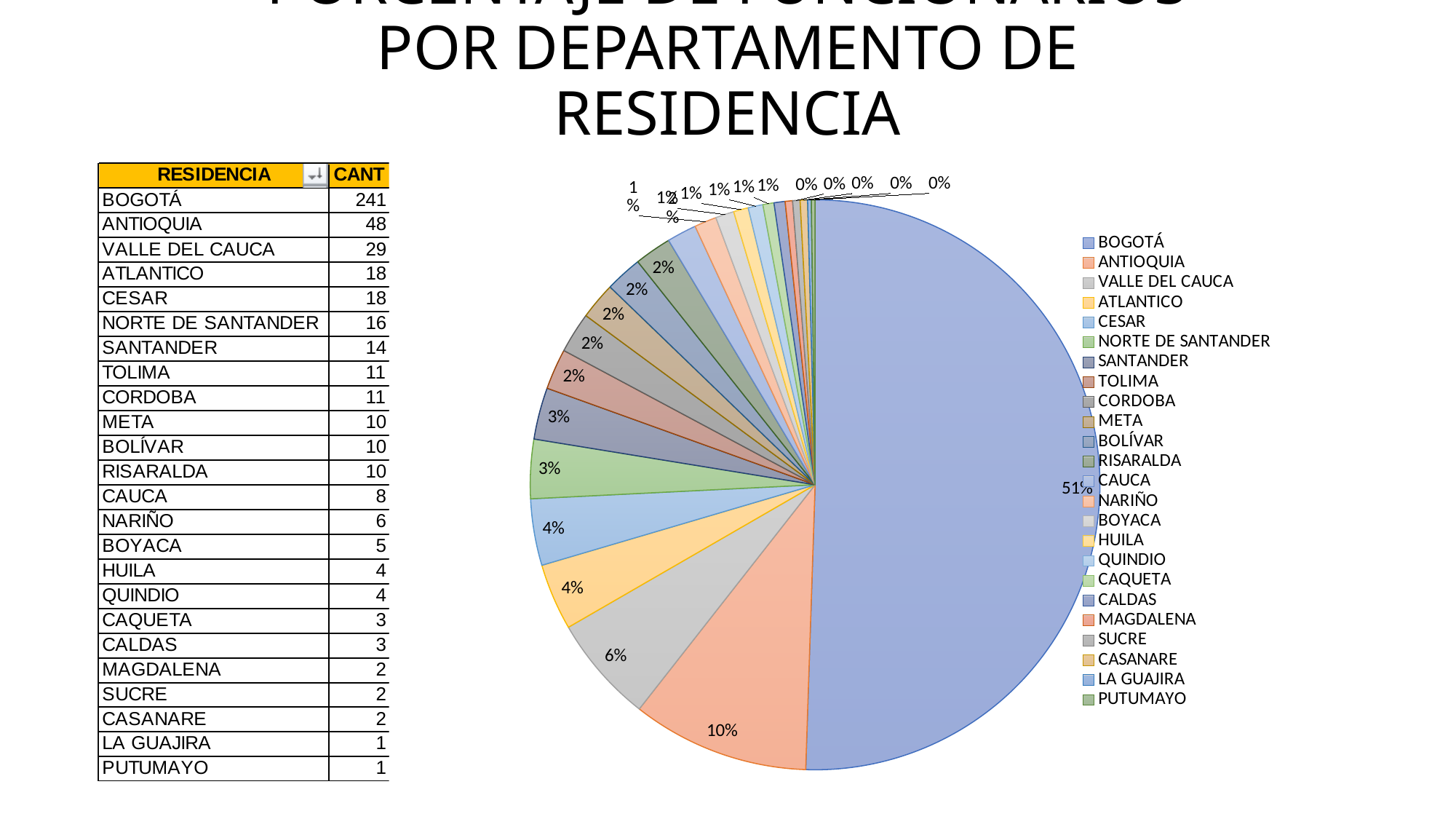
What is the difference in percentage points between the ANTIOQUIA slice and the VALLE DEL CAUCA slice? 4 What kind of chart is shown on the slide? pie chart Which department is listed first in the legend of the pie chart? BOGOTÁ How many entries does the legend of the pie chart list? 24 Which slice is larger, BOGOTÁ or ANTIOQUIA? BOGOTÁ Which department is listed last in the legend of the pie chart? PUTUMAYO Which department has the largest slice of the pie chart? BOGOTÁ What is the difference in percentage points between the BOGOTÁ slice and the ANTIOQUIA slice? 41 What share of the pie does BOGOTÁ represent? 51% Which slice is larger, ANTIOQUIA or VALLE DEL CAUCA? ANTIOQUIA What share of the pie does ANTIOQUIA represent? 10% What share of the pie does VALLE DEL CAUCA represent? 6%